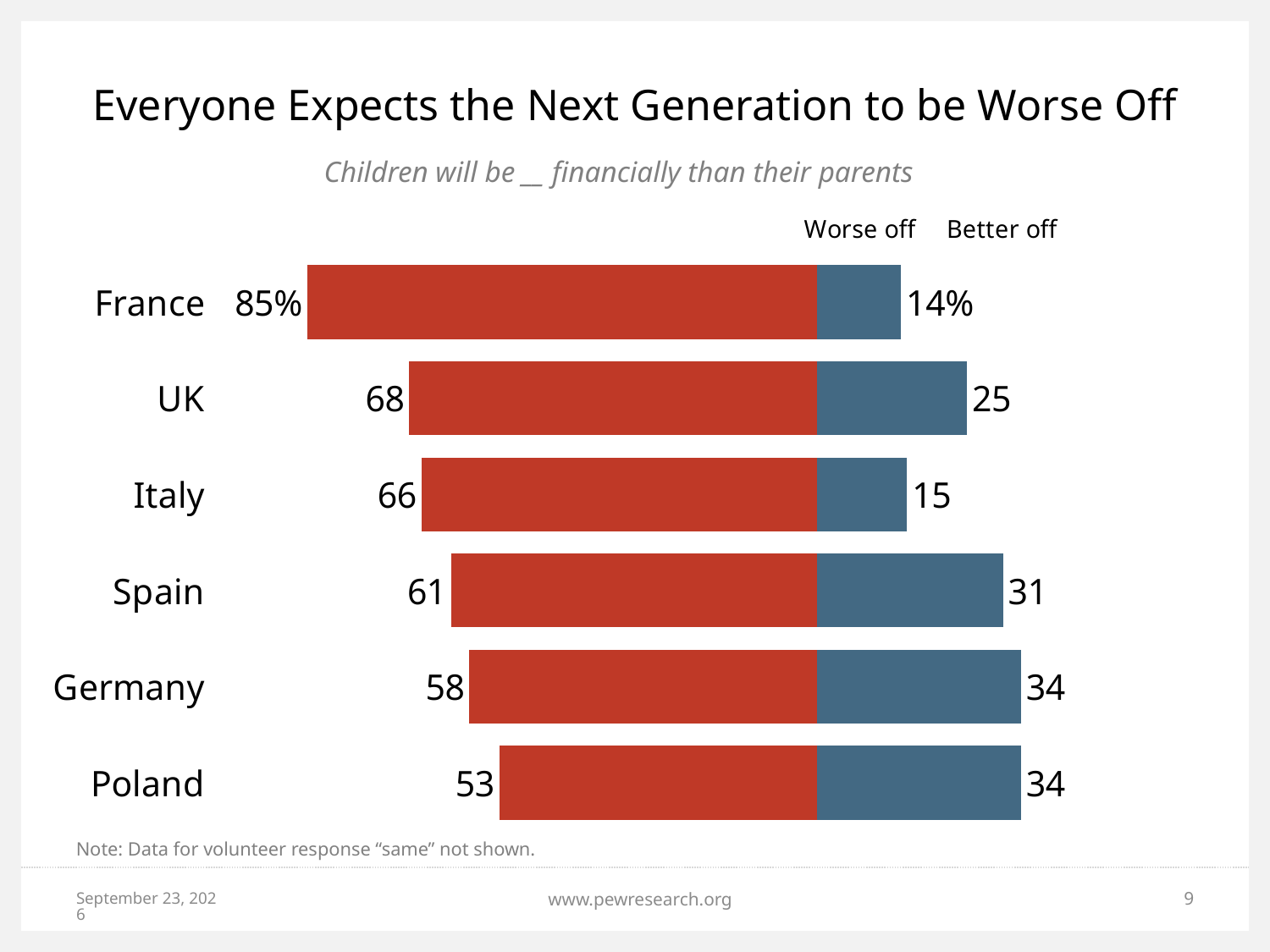
Which country has the lowest 'Better off' value? France How many series does the legend list? 2 Which country has the highest 'Worse off' value? France What is the 'Better off' value for Spain? 31 What kind of chart is shown on the slide? Bar chart How many countries are shown in the chart? 6 Which is larger, the 'Better off' value for Italy or for Spain? Spain What is the difference between the 'Worse off' and 'Better off' values for the UK? 43 What colour represents the 'Worse off' series? Red What percentage of respondents in France say children will be worse off financially than their parents? 85% Which country has the lowest 'Worse off' value? Poland What is the 'Worse off' value for Germany? 58